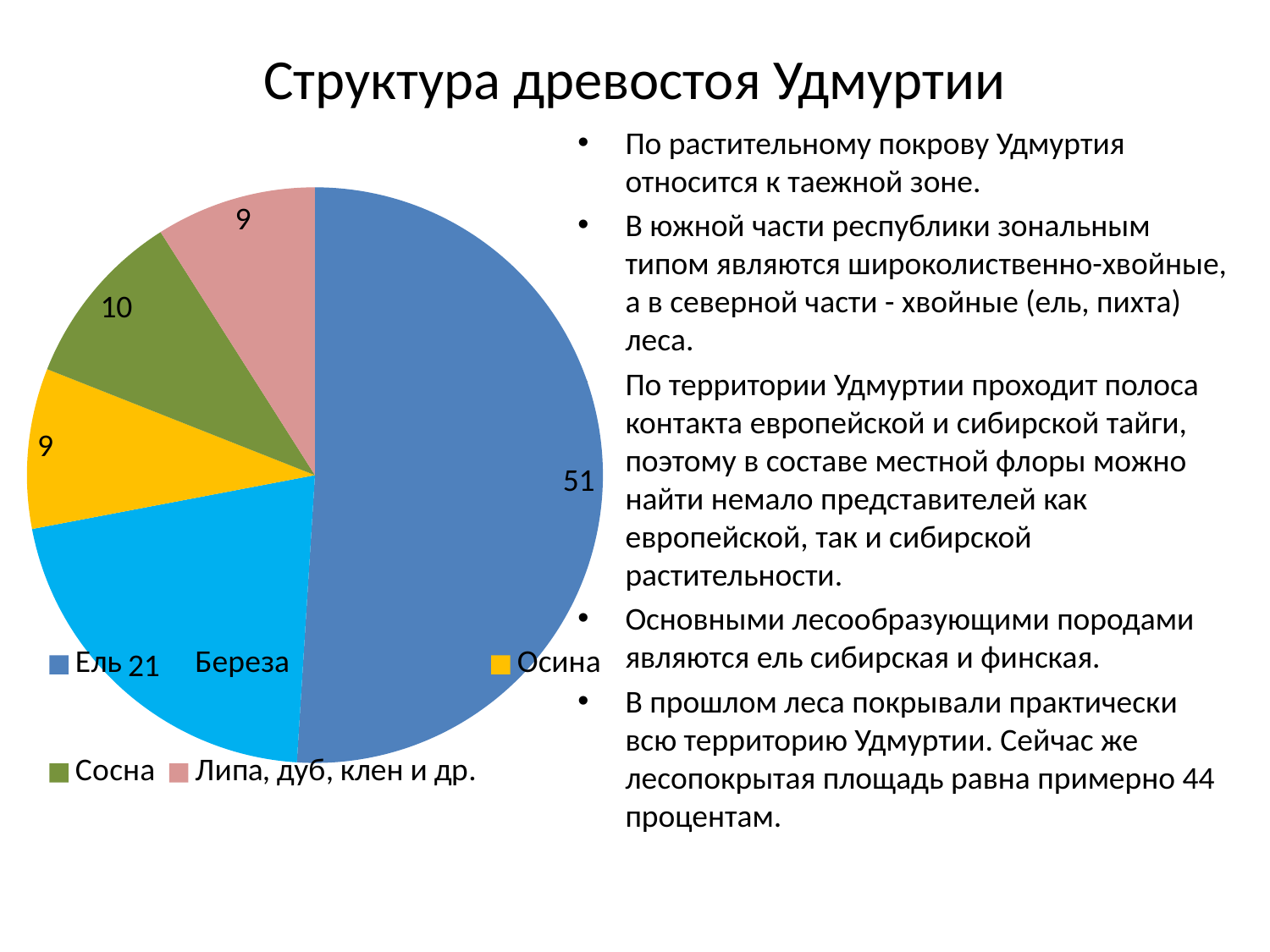
How many slices does the pie chart have? 5 What is the value for Осина in the pie chart? 9 Which is larger, the value for Береза or the value for Сосна? Береза What is the value for Ель in the pie chart? 51 What is the difference between the values for Ель and Береза? 30 What kind of chart is shown on the slide? pie chart Which category has the largest slice in the pie chart? Ель What is the value for Липа, дуб, клен и др. in the pie chart? 9 What share of the pie does Ель represent? 51% What is the value for Береза in the pie chart? 21 What colour is the Ель slice in the pie chart? blue What is the value for Сосна in the pie chart? 10